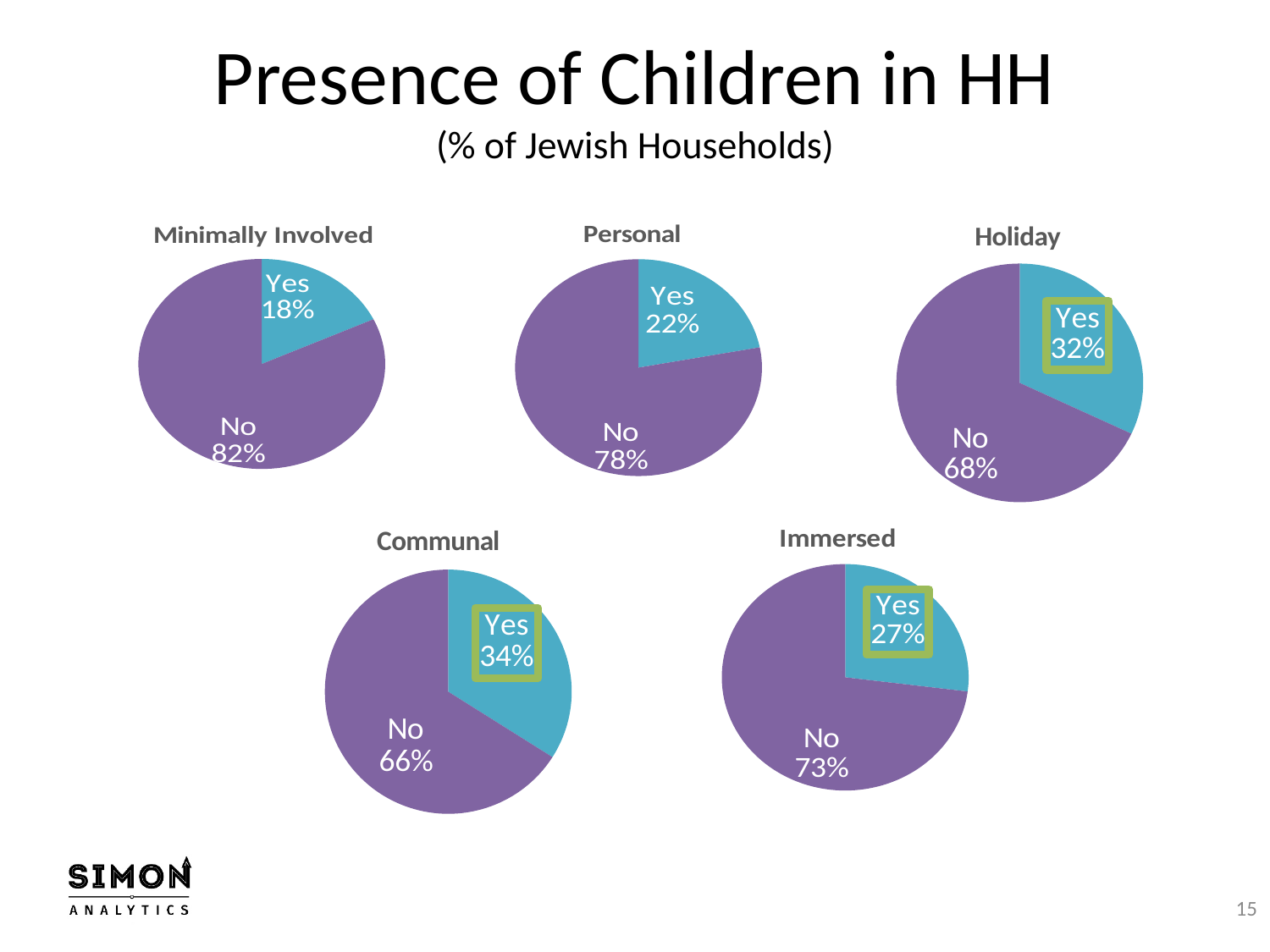
In the Personal pie chart, what percentage of households answered No? 78% How many slices does each pie chart have? 2 Across the five pie charts, which group has the highest Yes percentage? Communal In the Immersed pie chart, what percentage of households answered Yes? 27% Across the five pie charts, which group has the lowest Yes percentage? Minimally Involved Which is larger: the Yes share in the Holiday chart or the Yes share in the Immersed chart? Holiday In the Minimally Involved pie chart, what percentage of households answered Yes? 18% In the Communal pie chart, what percentage of households answered No? 66% What kind of chart is used for each group on this slide? Pie chart What is the difference between the Yes percentage in the Communal chart and the Yes percentage in the Minimally Involved chart? 16% In the Holiday pie chart, what is the share for Yes? 32% How many pie charts are shown on the slide? 5